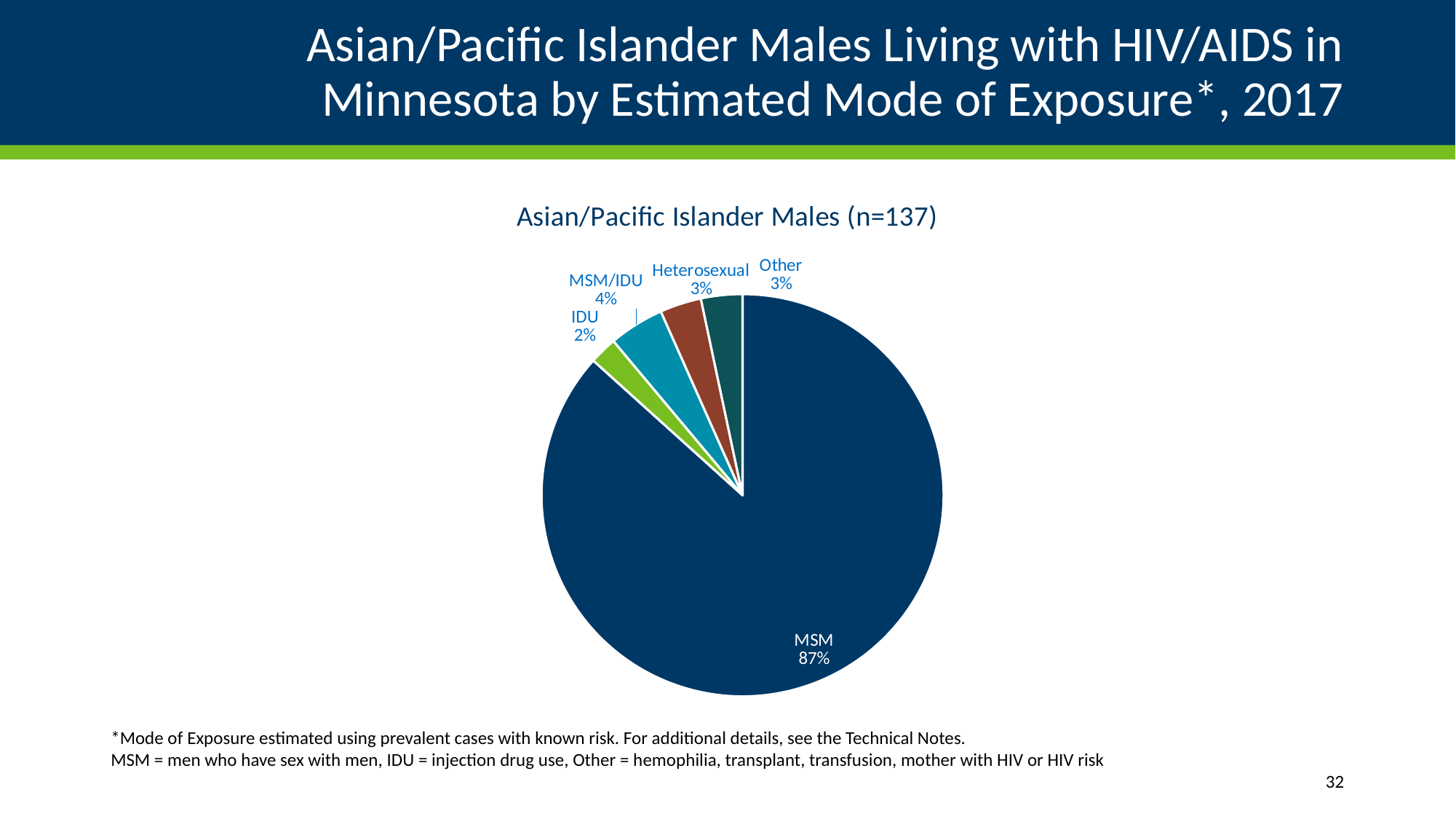
What is the title of the chart? Asian/Pacific Islander Males (n=137) Which mode of exposure has the smallest share of the pie? IDU What percentage of the pie is MSM? 87% What percentage of the pie is MSM/IDU? 4% Which mode of exposure has the largest share of the pie? MSM What percentage of the pie is IDU? 2% What is the sample size (n) given in the chart title? 137 What kind of chart is shown on the slide? Pie chart Which is larger, the share for MSM/IDU or the share for IDU? MSM/IDU What is the difference in percentage points between MSM and MSM/IDU? 83 How many slices does the pie chart have? 5 What percentage of the pie is Heterosexual? 3%